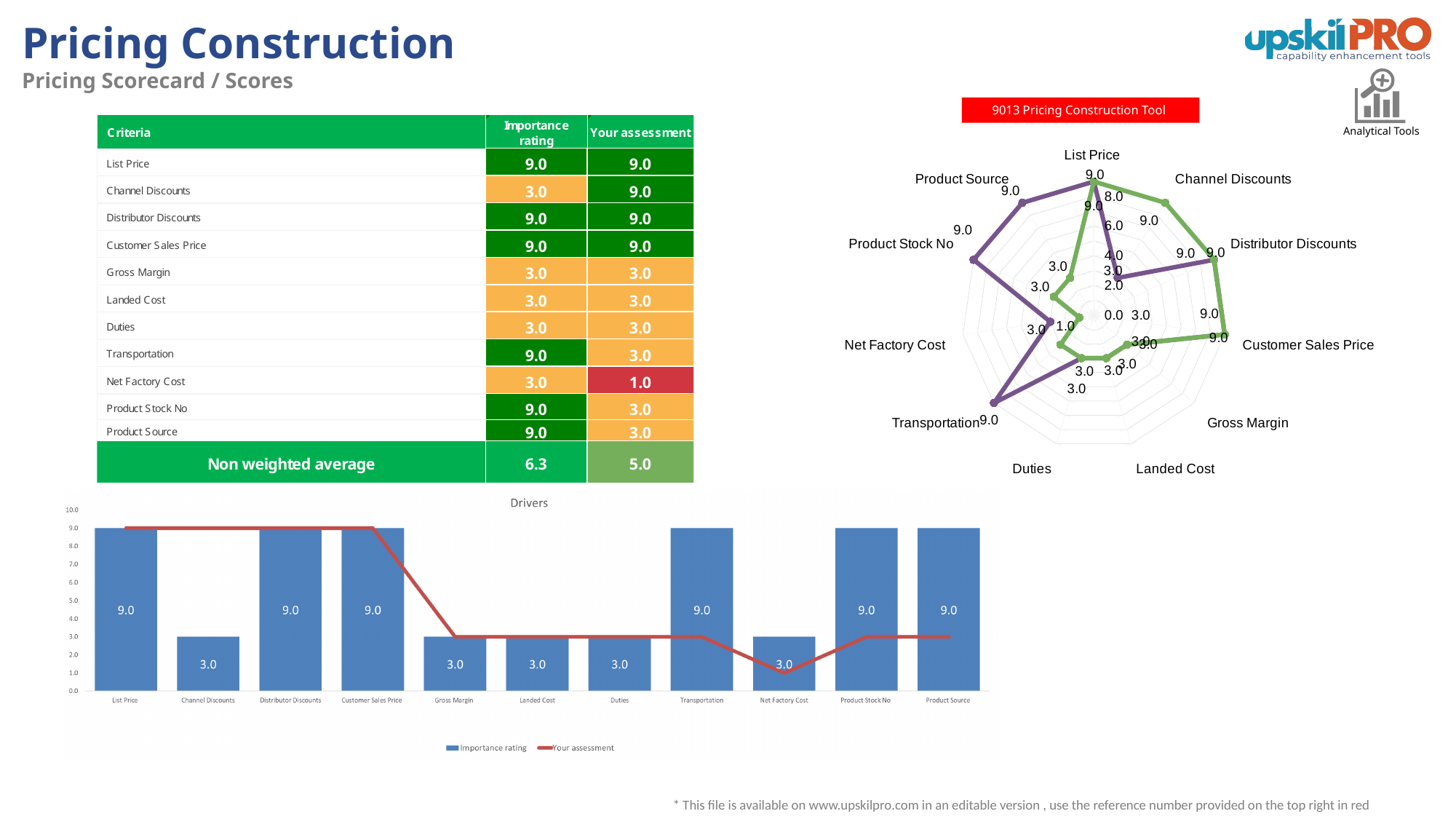
In the Drivers chart, what is the Importance rating for Channel Discounts? 3.0 How many series does the legend of the Drivers chart list? 2 What are the two legend entries of the Drivers chart? Importance rating and Your assessment In the Drivers chart, is the Your assessment value for Channel Discounts greater or less than 5.0? greater In the Drivers chart, which has the larger Importance rating, Gross Margin or Product Stock No? Product Stock No What kind of chart is the chart on the right side of the slide with List Price at the top? Radar chart In the Drivers chart, what is the difference between the Importance rating for List Price and for Channel Discounts? 6.0 In the Drivers chart, what is the Importance rating for Net Factory Cost? 3.0 How many categories are shown on the x axis of the Drivers chart? 11 In the Drivers chart, is the Your assessment value for Net Factory Cost greater or less than 2.0? less In the Drivers chart, what is the Importance rating for Transportation? 9.0 What kind of chart is the Drivers chart at the bottom of the slide? A bar chart combined with a line